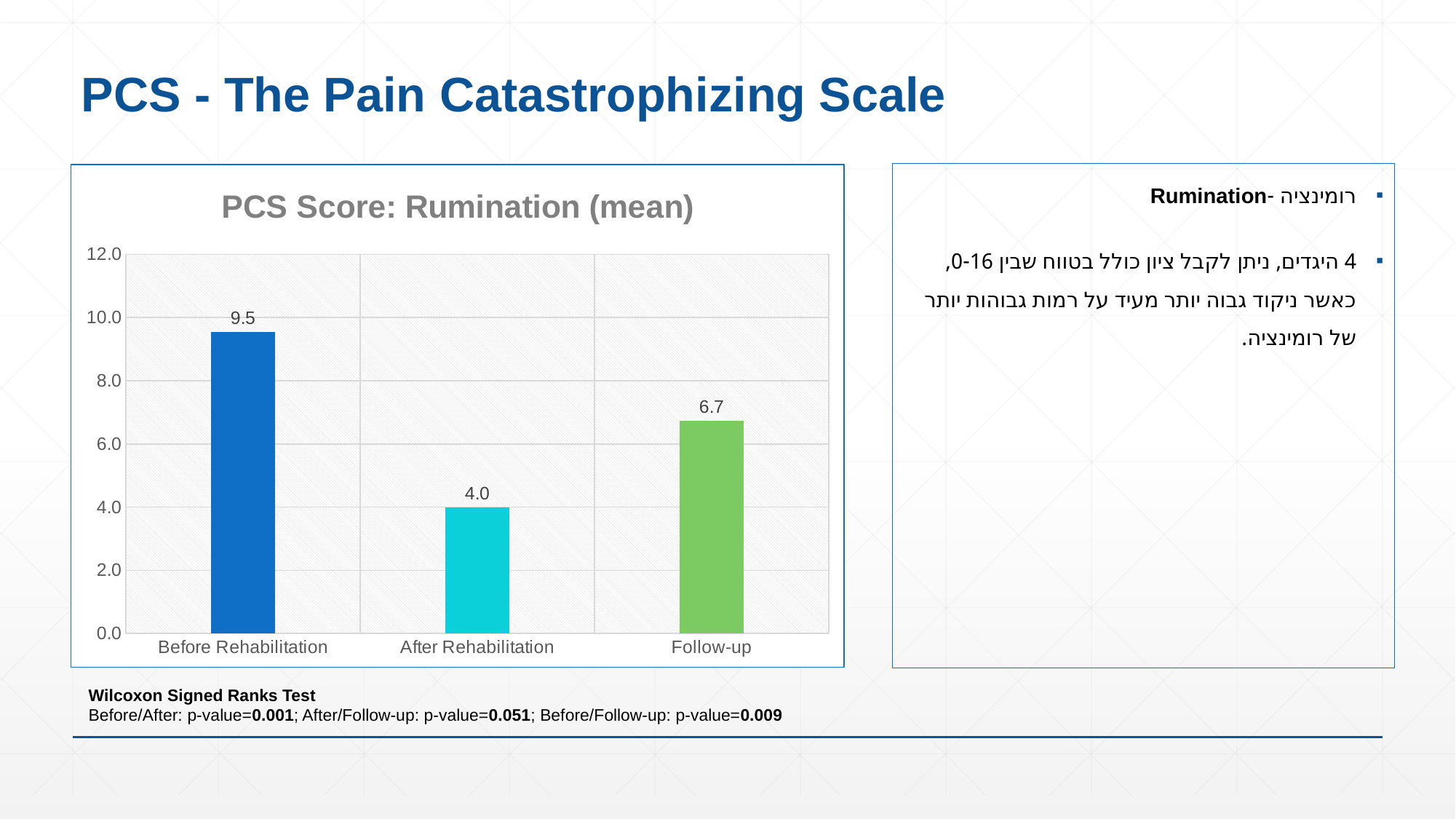
What kind of chart is shown on the slide? Bar chart Is the value for Before Rehabilitation greater or less than 8.0? greater Which time point has the lowest mean Rumination score? After Rehabilitation What is the mean PCS Rumination score Before Rehabilitation? 9.5 What is the mean PCS Rumination score at Follow-up? 6.7 What is the difference between the Follow-up and After Rehabilitation mean scores? 2.7 Which is larger, the Follow-up score or the After Rehabilitation score? Follow-up How many categories are shown on the x axis of the chart? 3 What is the mean PCS Rumination score After Rehabilitation? 4.0 What is the difference between the Before Rehabilitation and After Rehabilitation mean scores? 5.5 Which time point has the highest mean Rumination score? Before Rehabilitation What is the title of the chart? PCS Score: Rumination (mean)